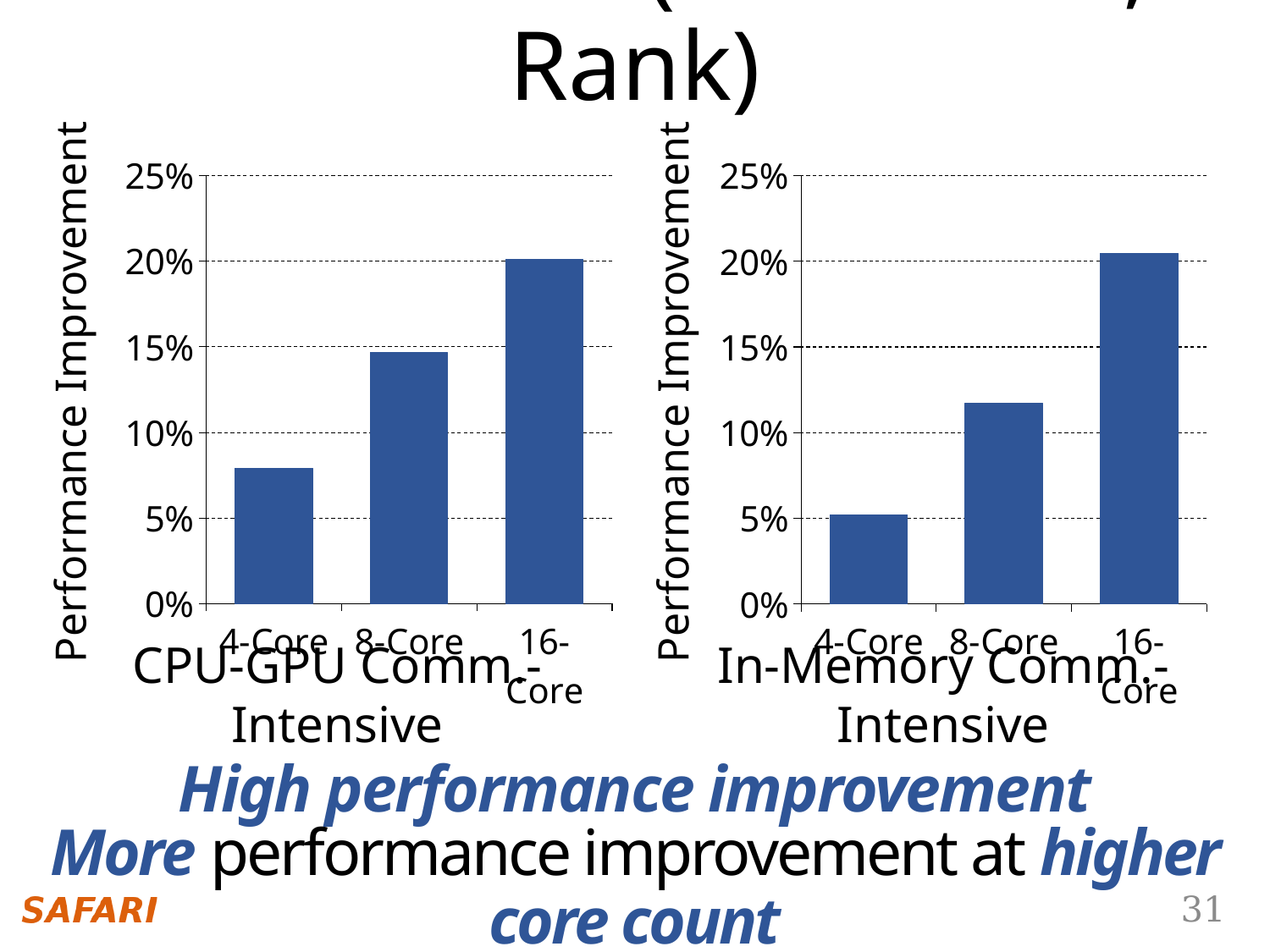
In the In-Memory Comm.-Intensive chart, is the value for 8-Core greater or less than 10%? greater In the CPU-GPU Comm.-Intensive chart, is the value for 16-Core greater or less than 15%? greater What type of chart is the CPU-GPU Comm.-Intensive chart? bar chart In the CPU-GPU Comm.-Intensive chart, is the value for 4-Core greater or less than 10%? less In the In-Memory Comm.-Intensive chart, which core count has the lowest performance improvement? 4-Core In the CPU-GPU Comm.-Intensive chart, which core count has the highest performance improvement? 16-Core Which is larger: the 4-Core value in the CPU-GPU Comm.-Intensive chart or the 4-Core value in the In-Memory Comm.-Intensive chart? CPU-GPU Comm.-Intensive How many core-count categories are shown in the CPU-GPU Comm.-Intensive chart? 3 In the CPU-GPU Comm.-Intensive chart, does performance improvement rise or fall as core count increases from 4-Core to 16-Core? rise What is the y-axis label of the In-Memory Comm.-Intensive chart? Performance Improvement